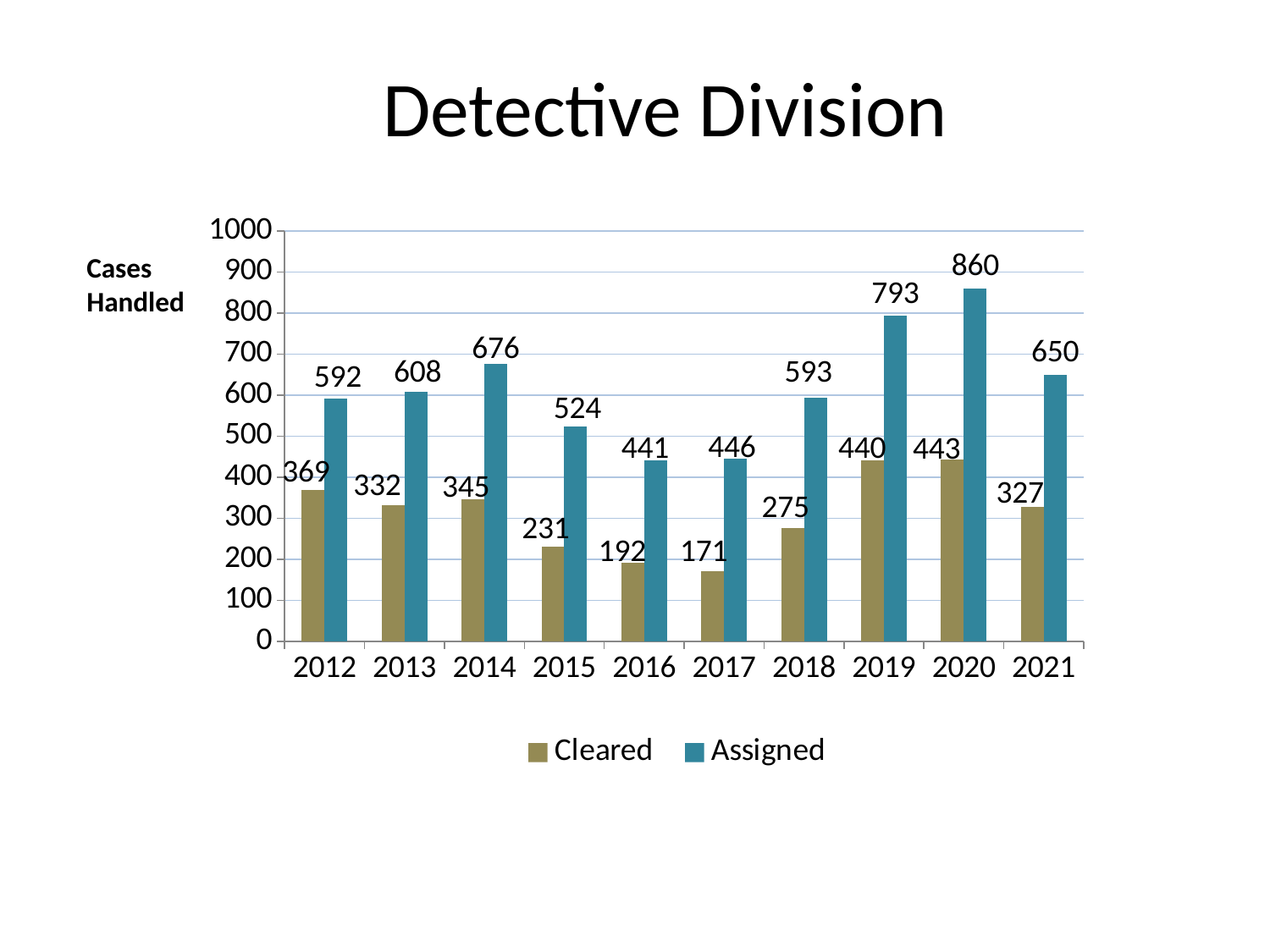
Is the Cleared value for 2016 greater or less than 200? less Which year has the highest Assigned value? 2020 What is the Cleared value for 2012? 369 How many series does the legend list? 2 What is the Cleared value for 2017? 171 What kind of chart is shown on the slide? bar chart What is the Assigned value for 2020? 860 How many years are shown on the x axis? 10 Which year has the lowest Cleared value? 2017 What is the difference between Assigned and Cleared in 2019? 353 Which is larger, the Assigned value for 2014 or the Assigned value for 2021? 2014 What is the title of the chart? Detective Division